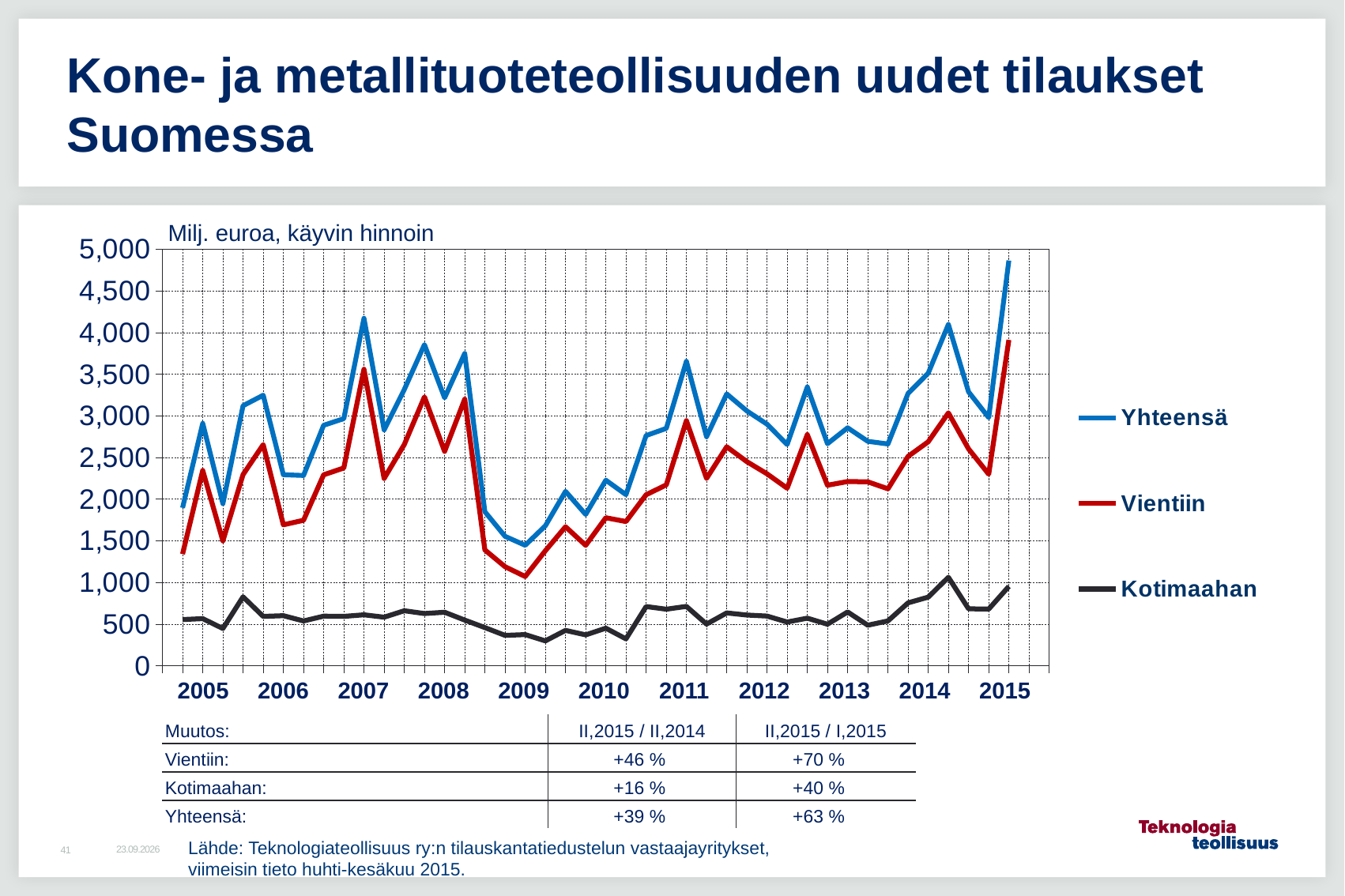
Which series has the highest values throughout the chart? Yhteensä Which series is drawn in red in the chart? Vientiin How many series does the legend list? 3 Which is larger in 2011, the value for Vientiin or the value for Kotimaahan? Vientiin What kind of chart is shown on the slide? line chart What unit label is shown above the chart? Milj. euroa, käyvin hinnoin Is the last value for Yhteensä in 2015 greater or less than 4,500? greater Is the last value for Vientiin in 2015 greater or less than 3,500? greater Does the Yhteensä series rise or fall from 2008 to 2009? fall Which series has the lowest values throughout the chart? Kotimaahan How many years are labelled on the x axis? 11 Is the value for Kotimaahan in 2009 greater or less than 500? less